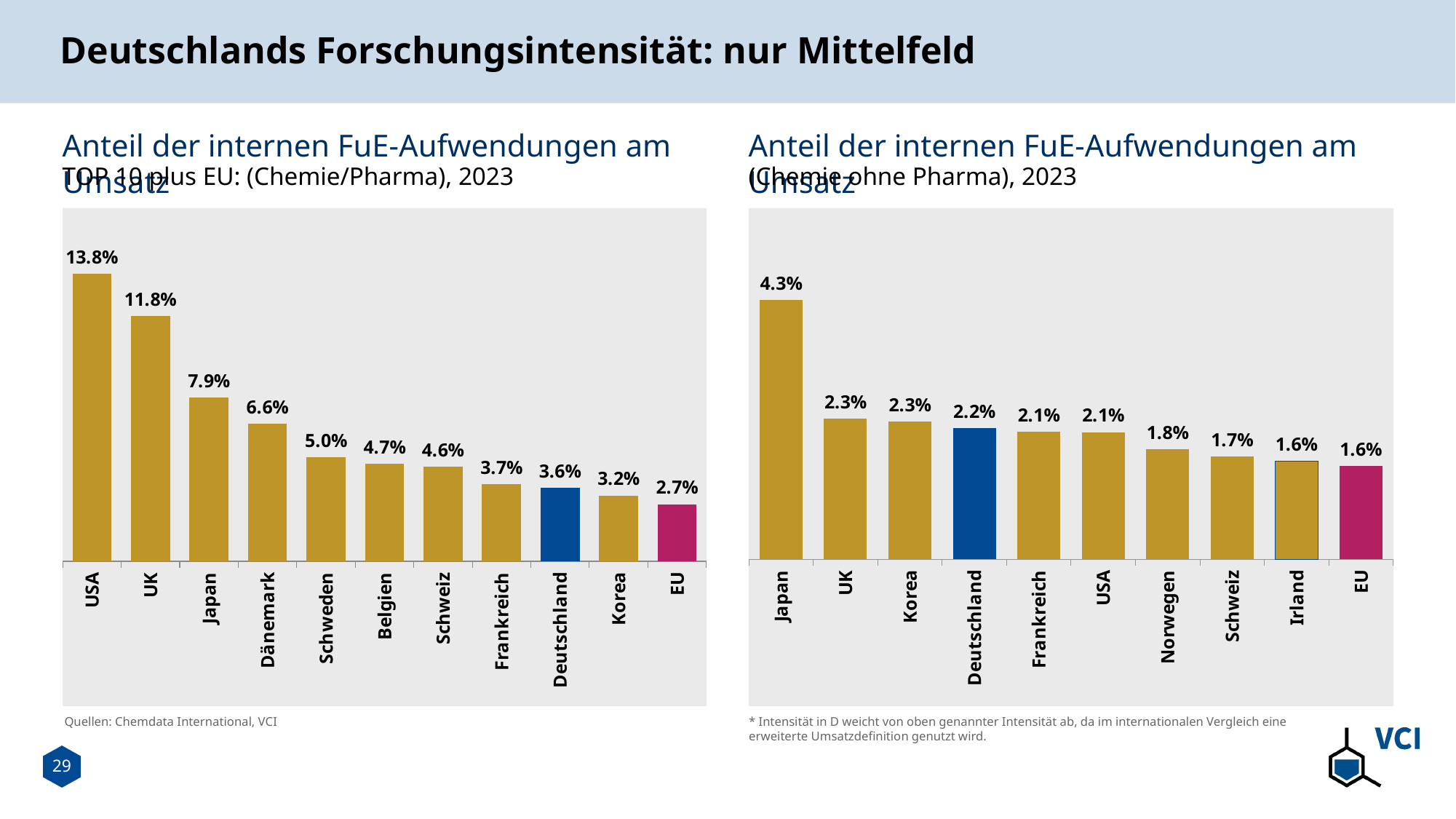
In the left chart (Chemie/Pharma), what is the difference between the values for USA and UK? 2.0 percentage points What kind of chart is the right chart (Chemie ohne Pharma)? Bar chart How many categories are shown in the right chart (Chemie ohne Pharma)? 10 In the right chart (Chemie ohne Pharma), which country has the highest value? Japan In the right chart (Chemie ohne Pharma), what is the difference between the values for Japan and Deutschland? 2.1 percentage points In the left chart (Chemie/Pharma), which category has the lowest value? EU In the left chart (Chemie/Pharma), what is the value for Deutschland? 3.6% In the left chart (Chemie/Pharma), do the values rise or fall from left to right along the x axis? Fall In the left chart (Chemie/Pharma), which is larger: the value for Japan or the value for Dänemark? Japan In the left chart (Chemie/Pharma), which country has the highest value? USA How many categories are shown in the left chart (Chemie/Pharma)? 11 In the right chart (Chemie ohne Pharma), what is the value for Japan? 4.3%